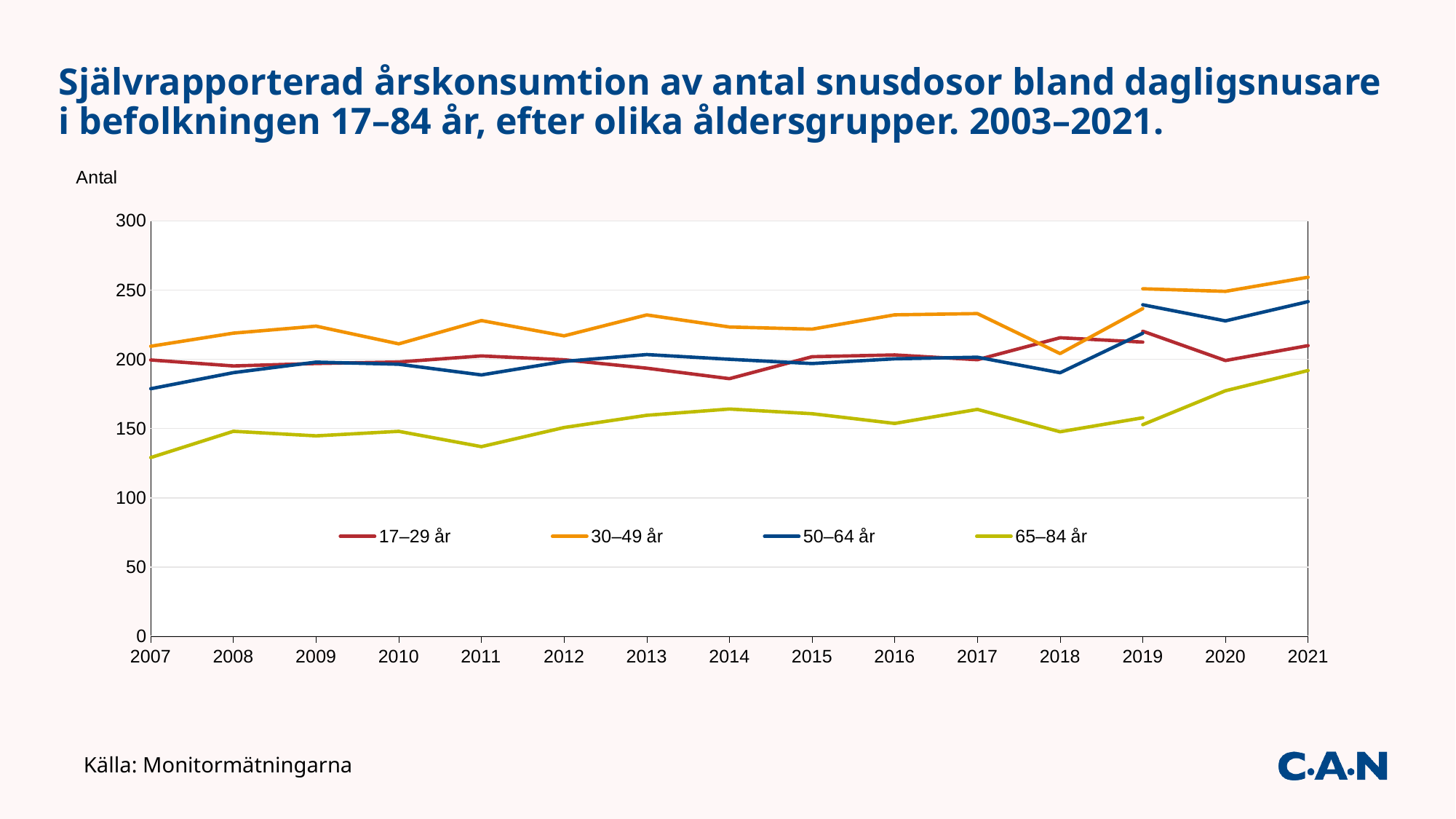
Which age group has the lowest value in 2021? 65–84 år Is the value for 17–29 år in 2014 greater or less than 200? less Is the value for 50–64 år in 2007 greater or less than 200? less How many years are shown along the x axis? 15 Is the value for 65–84 år in 2007 greater or less than 150? less In 2018, which is larger: the value for 17–29 år or the value for 50–64 år? 17–29 år Does the value for 65–84 år rise or fall from 2018 to 2021? rise What is the label on the y axis? Antal What kind of chart is shown on the slide? line chart How many series does the legend list? 4 Which age group has the highest value in 2021? 30–49 år